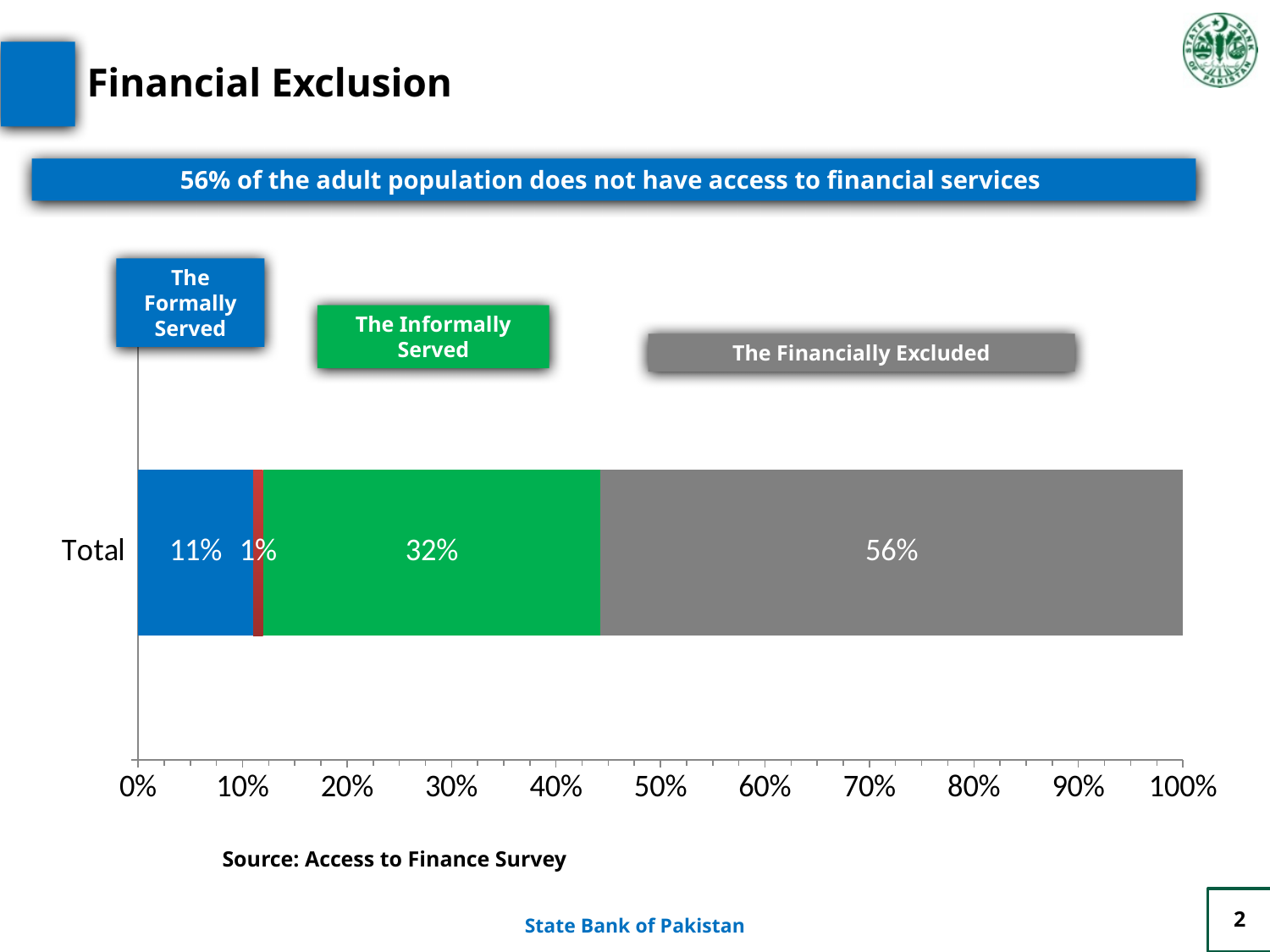
What colour is The Financially Excluded segment? Grey What is the total of all segments in the Total bar? 100% Which is larger, The Formally Served or The Informally Served? The Informally Served Which segment of the Total bar is the largest? The Financially Excluded Is the value for The Financially Excluded greater or less than 50%? greater What value is shown for The Informally Served segment? 32% How much larger is The Financially Excluded share than The Informally Served share? 24% What percentage of the adult population is shown as The Financially Excluded? 56% What is the difference between The Informally Served and The Formally Served values? 21% What value is shown for The Formally Served segment? 11% What is the smallest value printed on the Total bar? 1% What kind of chart is shown on the slide? Stacked bar chart